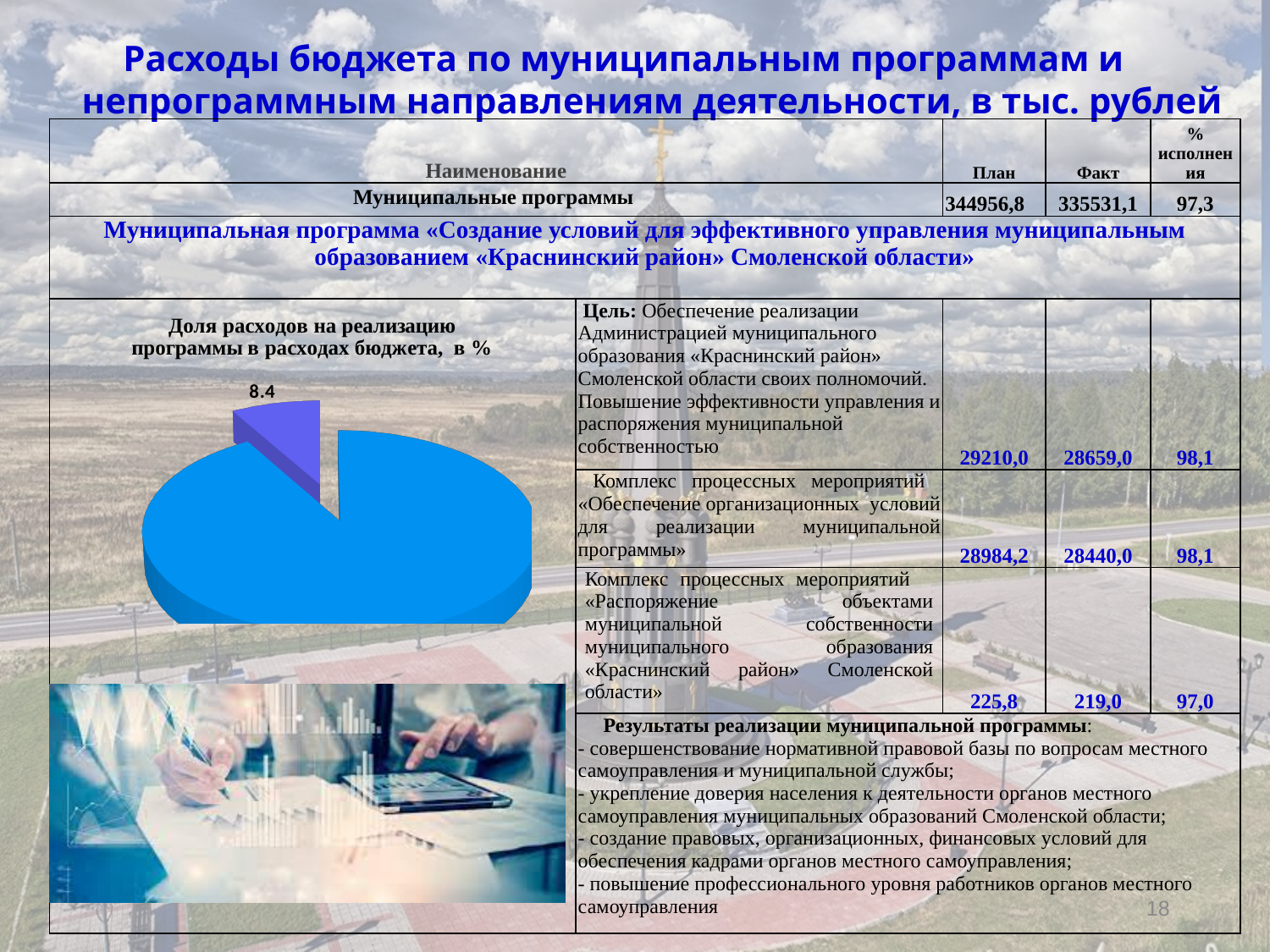
What value is printed on the labelled slice of the pie chart? 8.4 Which slice of the pie chart is the smallest? the purple slice labelled 8.4 What share of the pie does the exploded (separated) slice represent, according to its data label? 8.4 How many slices does the pie chart have? 2 Which slice of the pie chart is larger, the blue one or the purple one? the blue one What colour is the exploded slice of the pie chart? purple What kind of chart is shown on the slide? pie chart What is the title of the pie chart? Доля расходов на реализацию программы в расходах бюджета, в %